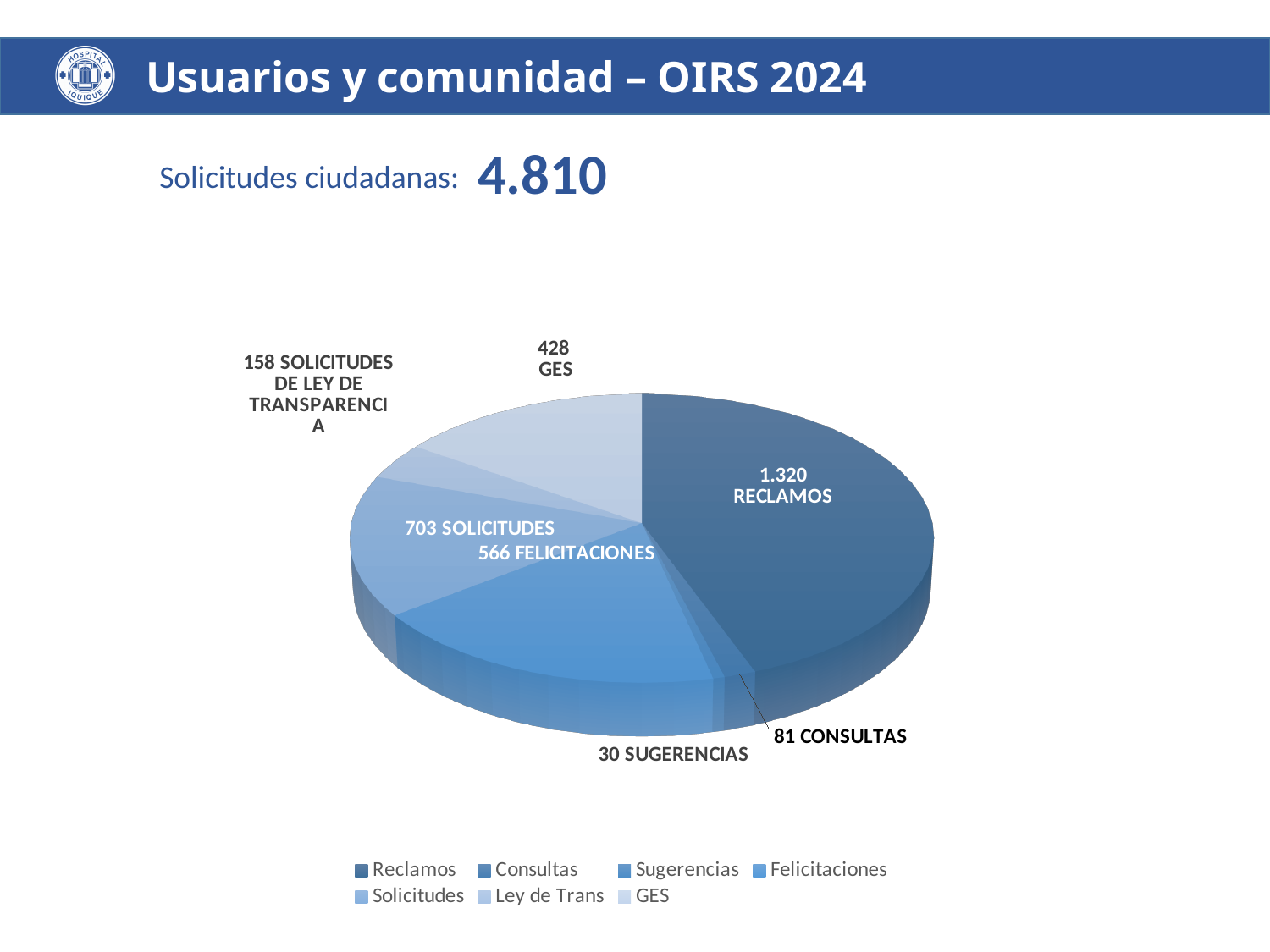
What is the difference between the values for Solicitudes and Felicitaciones in the pie chart? 137 How many slices does the pie chart have? 7 Which category has the smallest slice in the pie chart? Sugerencias Which is larger in the pie chart, Consultas or Solicitudes de Ley de Transparencia? Solicitudes de Ley de Transparencia How many entries does the legend of the pie chart list? 7 What kind of chart is shown on the slide? pie chart What is the value shown for Sugerencias in the pie chart? 30 Which category has the largest slice in the pie chart? Reclamos What is the value shown for GES in the pie chart? 428 What number of 'Solicitudes ciudadanas' is stated on the slide above the chart? 4.810 What is the value shown for Felicitaciones in the pie chart? 566 What is the value shown for Reclamos in the pie chart? 1.320